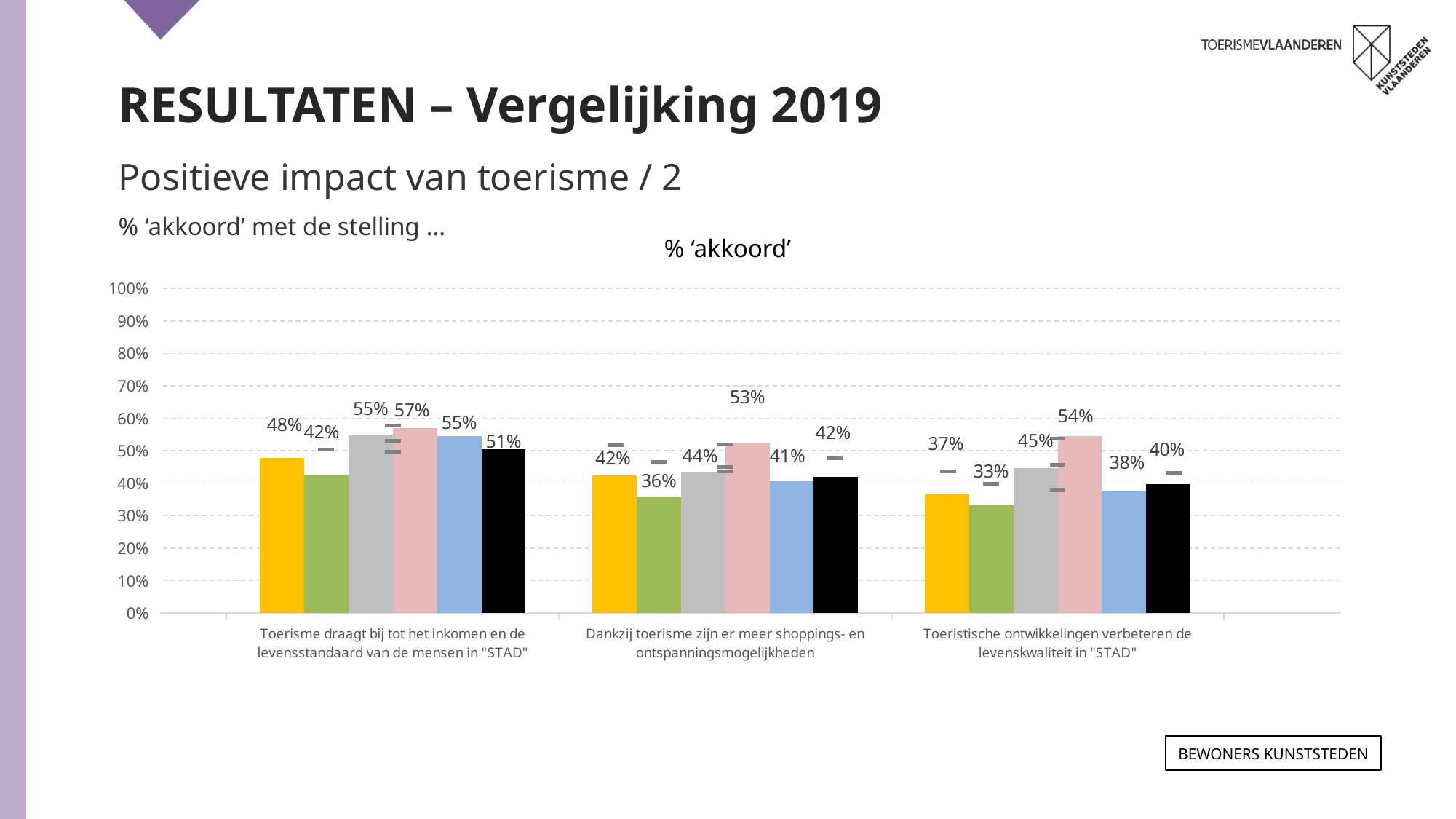
What is the value of the green bar for "Dankzij toerisme zijn er meer shoppings- en ontspanningsmogelijkheden"? 36% What is the title of the chart? % ‘akkoord’ Which is larger for "Toeristische ontwikkelingen verbeteren de levenskwaliteit in 'STAD'": the yellow bar or the grey bar? the grey bar (45%) Which bar has the lowest value for "Dankzij toerisme zijn er meer shoppings- en ontspanningsmogelijkheden"? the green bar (36%) Is the value of the yellow bar for "Toeristische ontwikkelingen verbeteren de levenskwaliteit in 'STAD'" greater or less than 40%? less How many bars are shown for each statement category? 6 How many statement categories are shown along the x axis of the chart? 3 What is the value of the black bar for "Toeristische ontwikkelingen verbeteren de levenskwaliteit in 'STAD'"? 40% Which bar has the highest value for "Toeristische ontwikkelingen verbeteren de levenskwaliteit in 'STAD'"? the pink bar (54%) What is the value of the pink bar for "Toerisme draagt bij tot het inkomen en de levensstandaard van de mensen in 'STAD'"? 57% What is the difference between the pink bar and the green bar for "Toerisme draagt bij tot het inkomen en de levensstandaard van de mensen in 'STAD'"? 15 percentage points What kind of chart is shown on the slide? bar chart